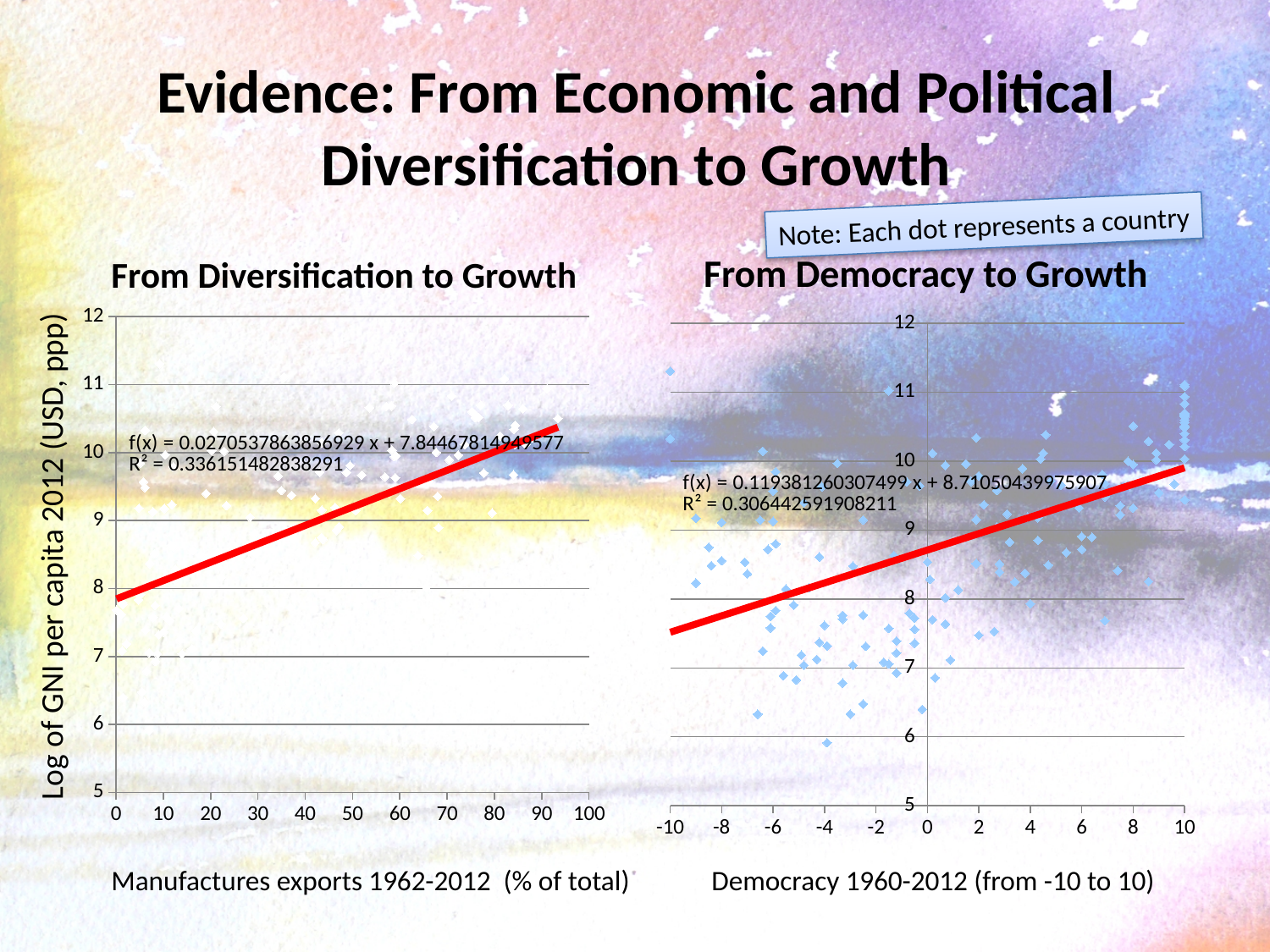
What is the intercept of the trend line equation on the 'From Democracy to Growth' chart? 8.71050439975907 In the 'From Democracy to Growth' chart, does the fitted trend line rise or fall as the democracy score increases? rise What is the slope of the trend line equation on the 'From Democracy to Growth' chart? 0.119381260307499 What is the R² value shown on the 'From Democracy to Growth' chart? 0.306442591908211 In the 'From Diversification to Growth' chart, does the fitted trend line rise or fall as manufactures exports increase? rise What kind of chart is the 'From Diversification to Growth' chart? scatter chart What is the x-axis label of the 'From Democracy to Growth' chart? Democracy 1960-2012 (from -10 to 10) What kind of chart is the 'From Democracy to Growth' chart? scatter chart Which chart shows the higher R² value, 'From Diversification to Growth' or 'From Democracy to Growth'? From Diversification to Growth What is the R² value shown on the 'From Diversification to Growth' chart? 0.336151482838291 According to the note on the slide, what does each dot in the charts represent? a country What is the slope of the trend line equation on the 'From Diversification to Growth' chart? 0.0270537863856929